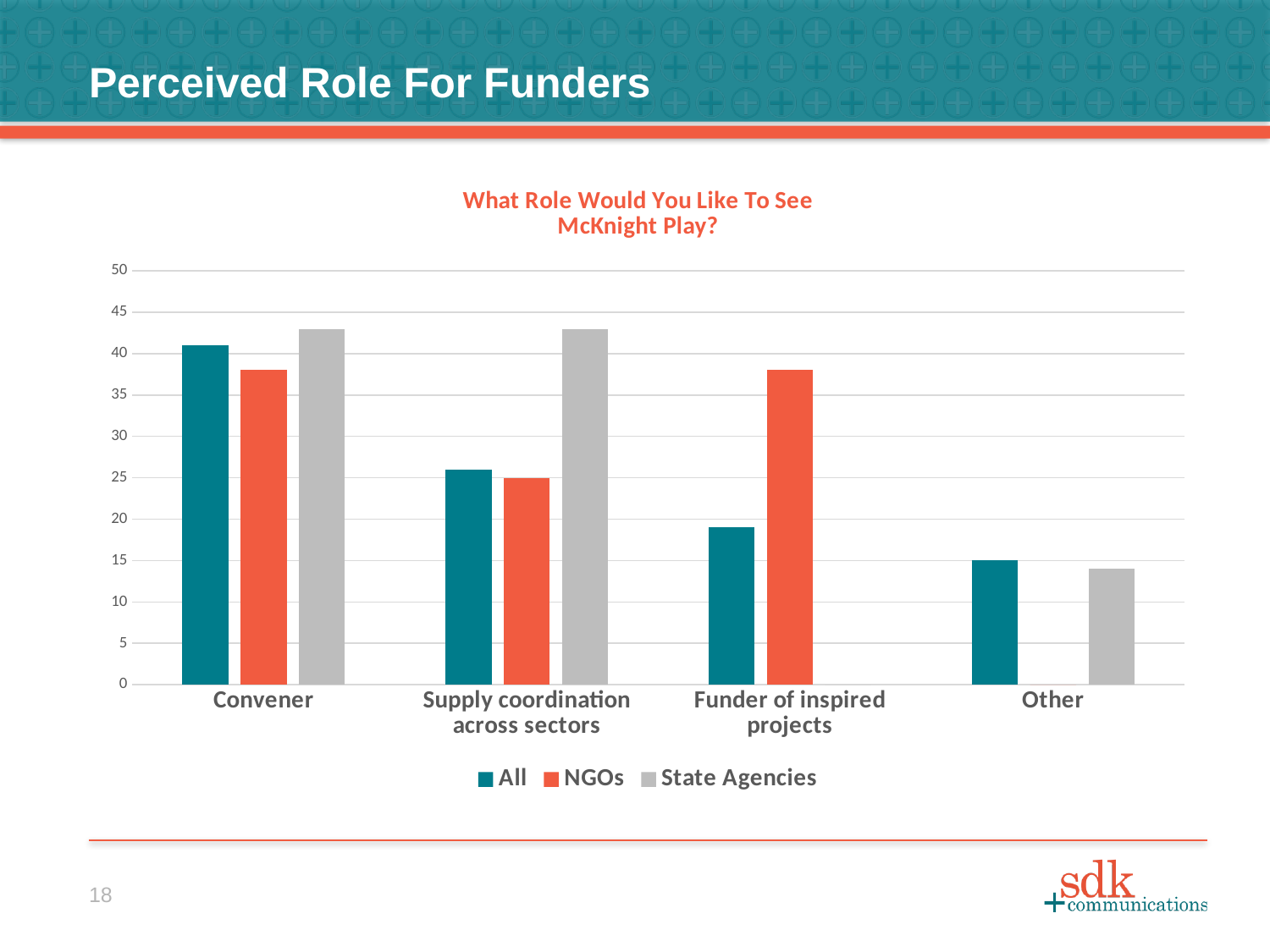
Which series is shown in orange in the chart? NGOs For the All series, which category has the highest value? Convener For Supply coordination across sectors, which is larger: the All value or the State Agencies value? State Agencies What is the title of the chart? What Role Would You Like To See McKnight Play? For the All series, which category has the lowest value? Other What kind of chart is shown on the slide? bar chart For Funder of inspired projects, which is larger: the All value or the NGOs value? NGOs How many series does the chart's legend list? 3 Is the NGOs value for Funder of inspired projects greater or less than 35? greater Is the State Agencies value for Convener greater or less than 40? greater Is the All value for Funder of inspired projects greater or less than 25? less How many categories are shown on the x axis of the chart? 4